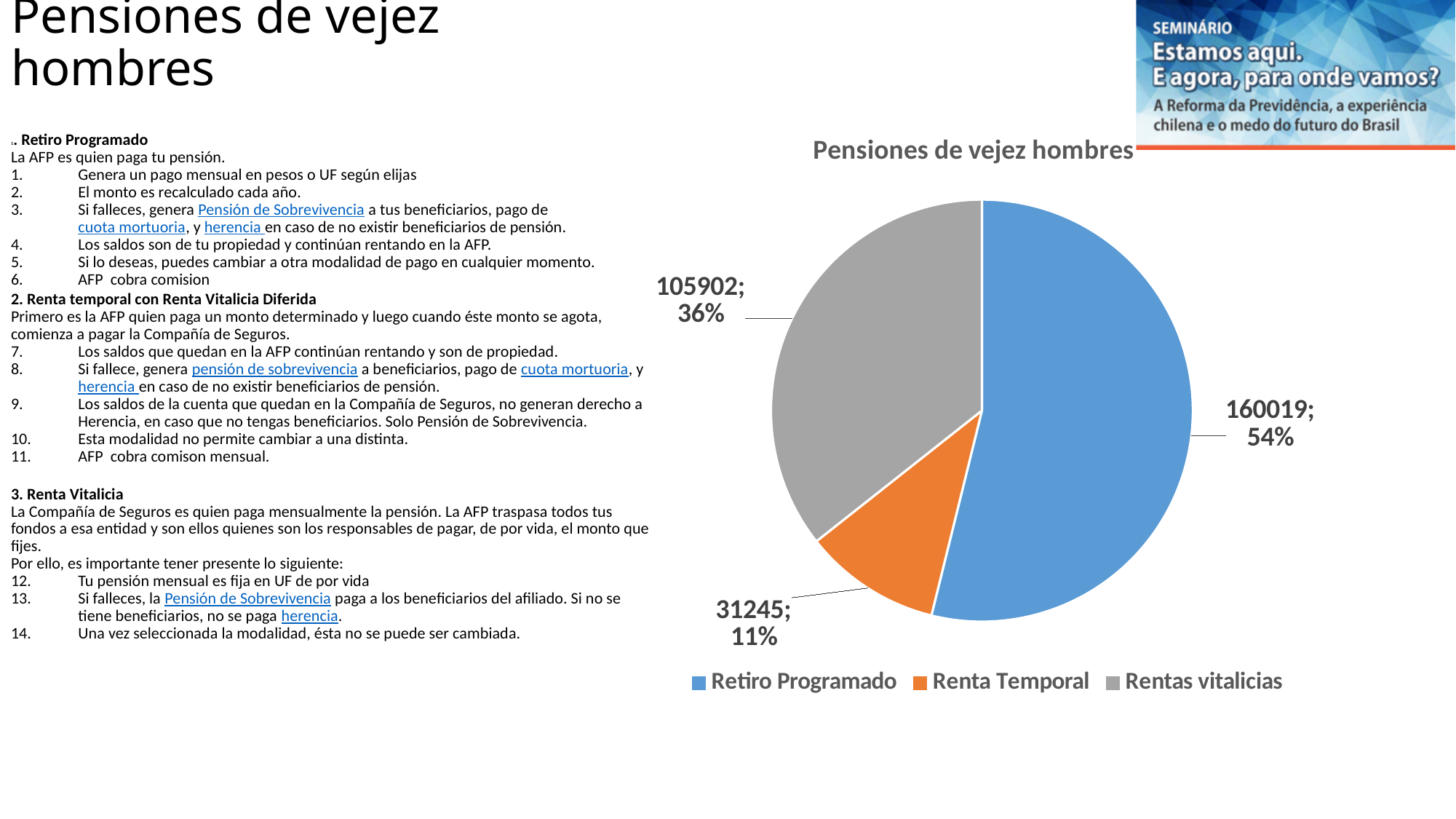
What is the value for Rentas vitalicias? 105902 Which category has the smallest slice? Renta Temporal What type of chart is shown on the slide? pie chart What is the value for Retiro Programado? 160019 What is the difference between the values for Retiro Programado and Rentas vitalicias? 54117 What is the value for Renta Temporal? 31245 What share of the pie does Retiro Programado represent? 54% What is the title of the chart? Pensiones de vejez hombres How many slices does the pie chart have? 3 What share of the pie does Renta Temporal represent? 11% How many entries does the legend list? 3 Which category has the largest slice? Retiro Programado